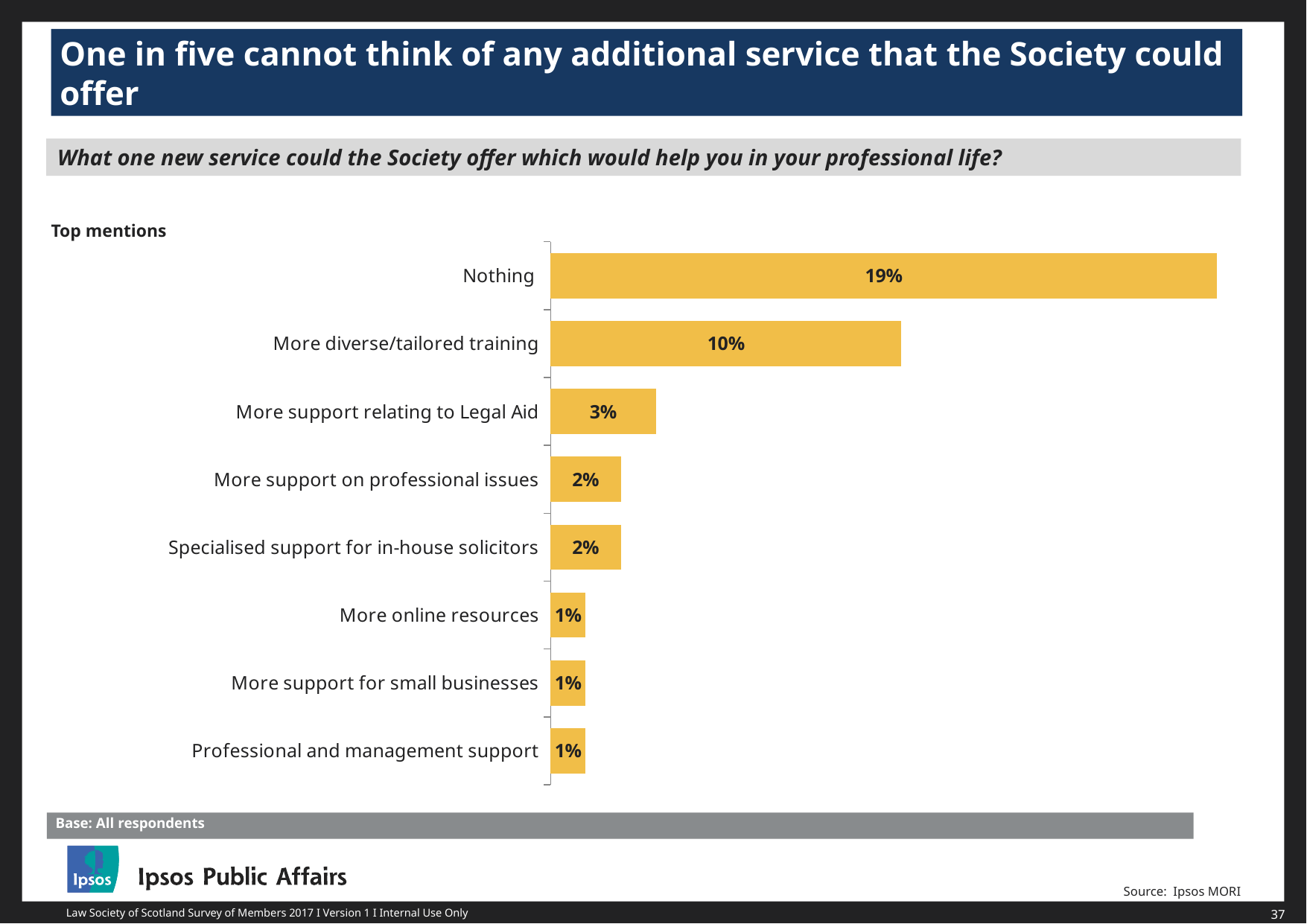
What colour are the bars in the chart? Yellow What is the difference between 'More diverse/tailored training' and 'More support relating to Legal Aid'? 7 percentage points How many categories have a value of 1%? 3 How many categories are shown in the chart? 8 What kind of chart is shown on the slide? Bar chart Which is larger: 'More support on professional issues' or 'More support for small businesses'? More support on professional issues What is the difference between 'Nothing' and 'More diverse/tailored training'? 9 percentage points What percentage mentioned 'More support relating to Legal Aid'? 3% What percentage of respondents said 'Nothing'? 19% Which category has the highest value? Nothing What is the value for 'More online resources'? 1% What is the value for 'More diverse/tailored training'? 10%